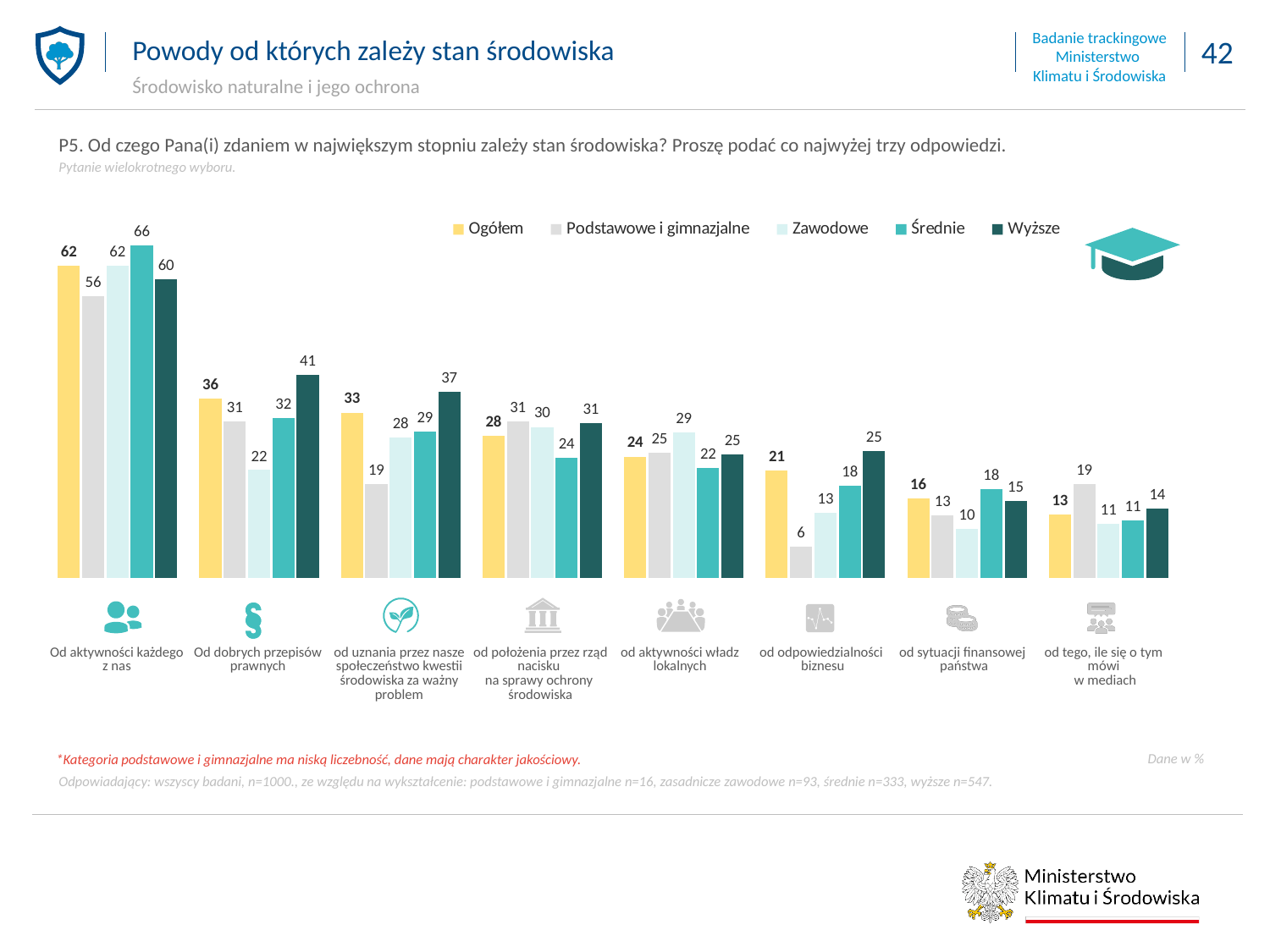
Which is larger for "od uznania przez nasze społeczeństwo kwestii środowiska za ważny problem": the Wyższe value or the Podstawowe i gimnazjalne value? Wyższe What kind of chart is shown on the slide? Bar chart What is the Wyższe value for "Od dobrych przepisów prawnych"? 41 What is the Podstawowe i gimnazjalne value for "od odpowiedzialności biznesu"? 6 What is the Ogółem value for "Od aktywności każdego z nas"? 62 How many series does the legend list? 5 What is the Zawodowe value for "od sytuacji finansowej państwa"? 10 How many categories are shown on the x axis of the chart? 8 What is the difference between the Średnie and Podstawowe i gimnazjalne values for "Od aktywności każdego z nas"? 10 Which category has the highest Ogółem value? Od aktywności każdego z nas Which series is shown in yellow in the legend? Ogółem Which category has the lowest Ogółem value? od tego, ile się o tym mówi w mediach